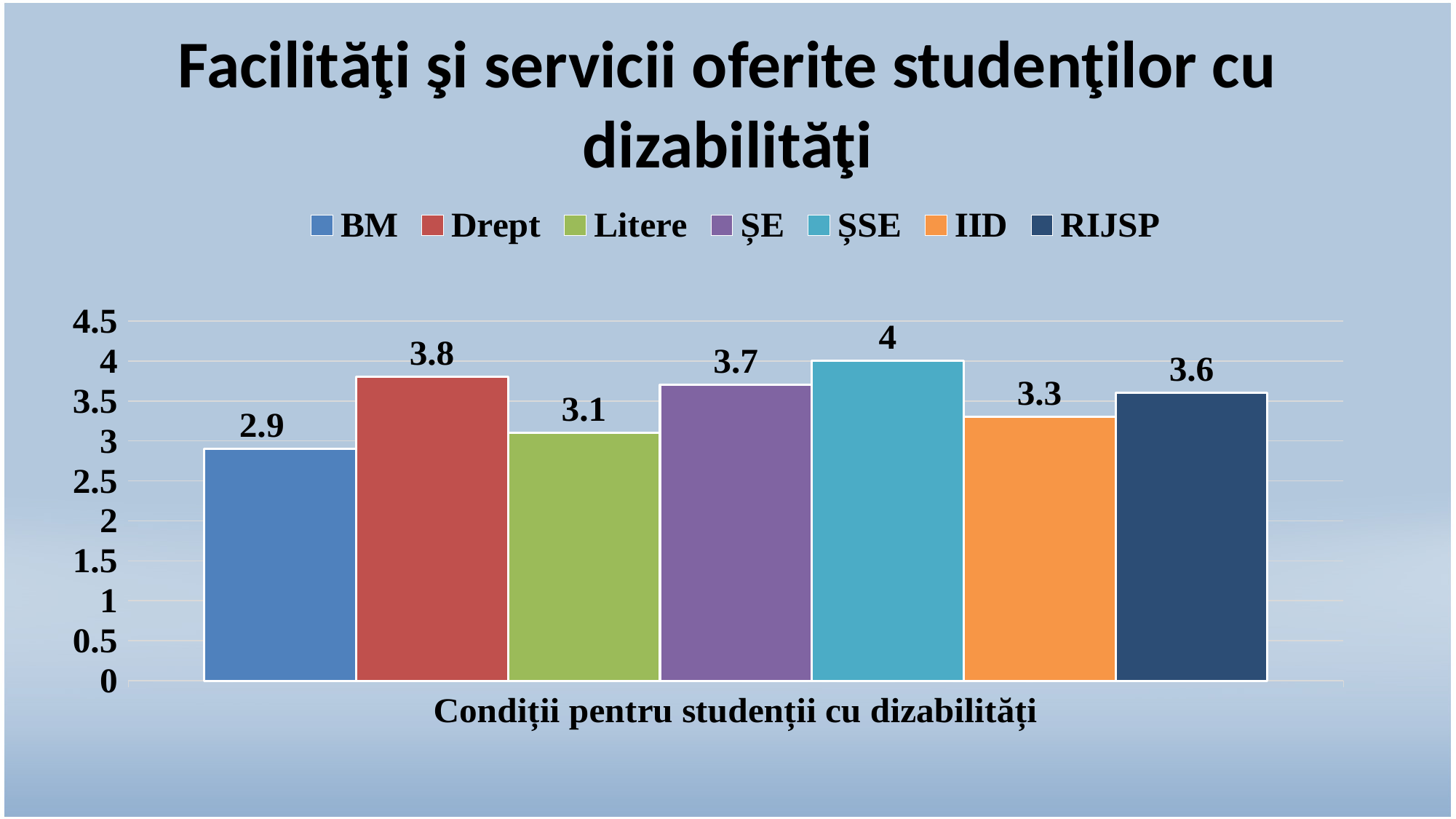
What is the x-axis label of the chart? Condiţii pentru studenţii cu dizabilităţi What is the value for IID? 3.3 What is the difference between the values for ŞSE and BM? 1.1 Is the value for Litere greater or less than 3.5? less What is the value for Drept? 3.8 What kind of chart is shown on the slide? bar chart Which series has the highest value? ŞSE Which series has the lowest value? BM What is the value for BM? 2.9 Which is larger, the value for ŞE or the value for RIJSP? ŞE What is the difference between the values for Drept and Litere? 0.7 How many series does the legend list? 7